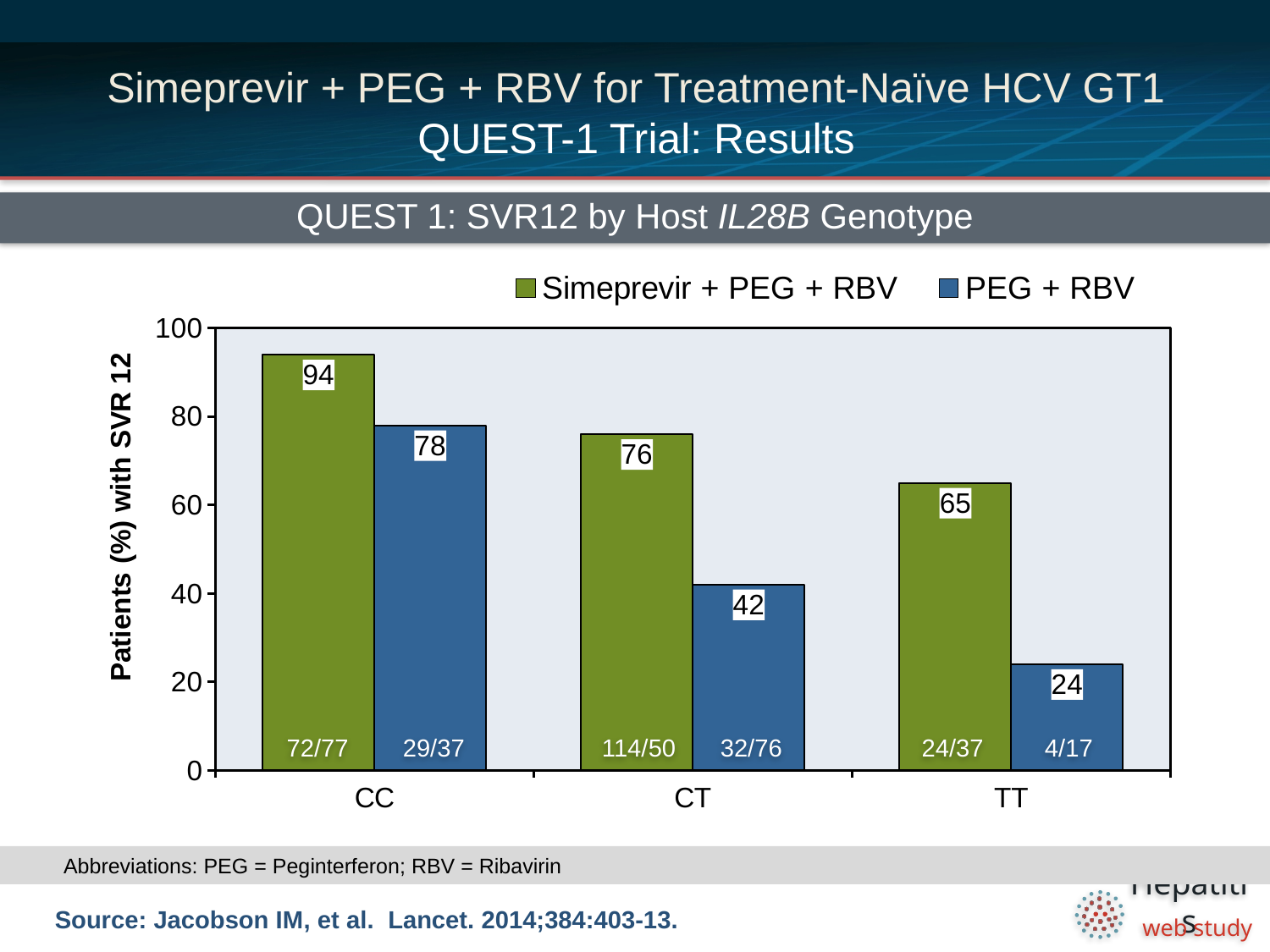
How many genotype categories are shown on the x axis? 3 What is the SVR12 rate for PEG + RBV in the TT genotype group? 24 What is the difference in SVR12 rate between Simeprevir + PEG + RBV and PEG + RBV in the TT genotype group? 41 What is the SVR12 rate for Simeprevir + PEG + RBV in the CC genotype group? 94 Which genotype group has the highest SVR12 rate for Simeprevir + PEG + RBV? CC Which is larger: the SVR12 rate for PEG + RBV in the CC group or for Simeprevir + PEG + RBV in the CT group? PEG + RBV in the CC group What kind of chart is shown on the slide? Bar chart Do the SVR12 rates for Simeprevir + PEG + RBV rise or fall from CC to TT? Fall What is the SVR12 rate for PEG + RBV in the CT genotype group? 42 Which genotype group has the lowest SVR12 rate for PEG + RBV? TT How many series does the legend list? 2 What is the difference in SVR12 rate between Simeprevir + PEG + RBV and PEG + RBV in the CT genotype group? 34